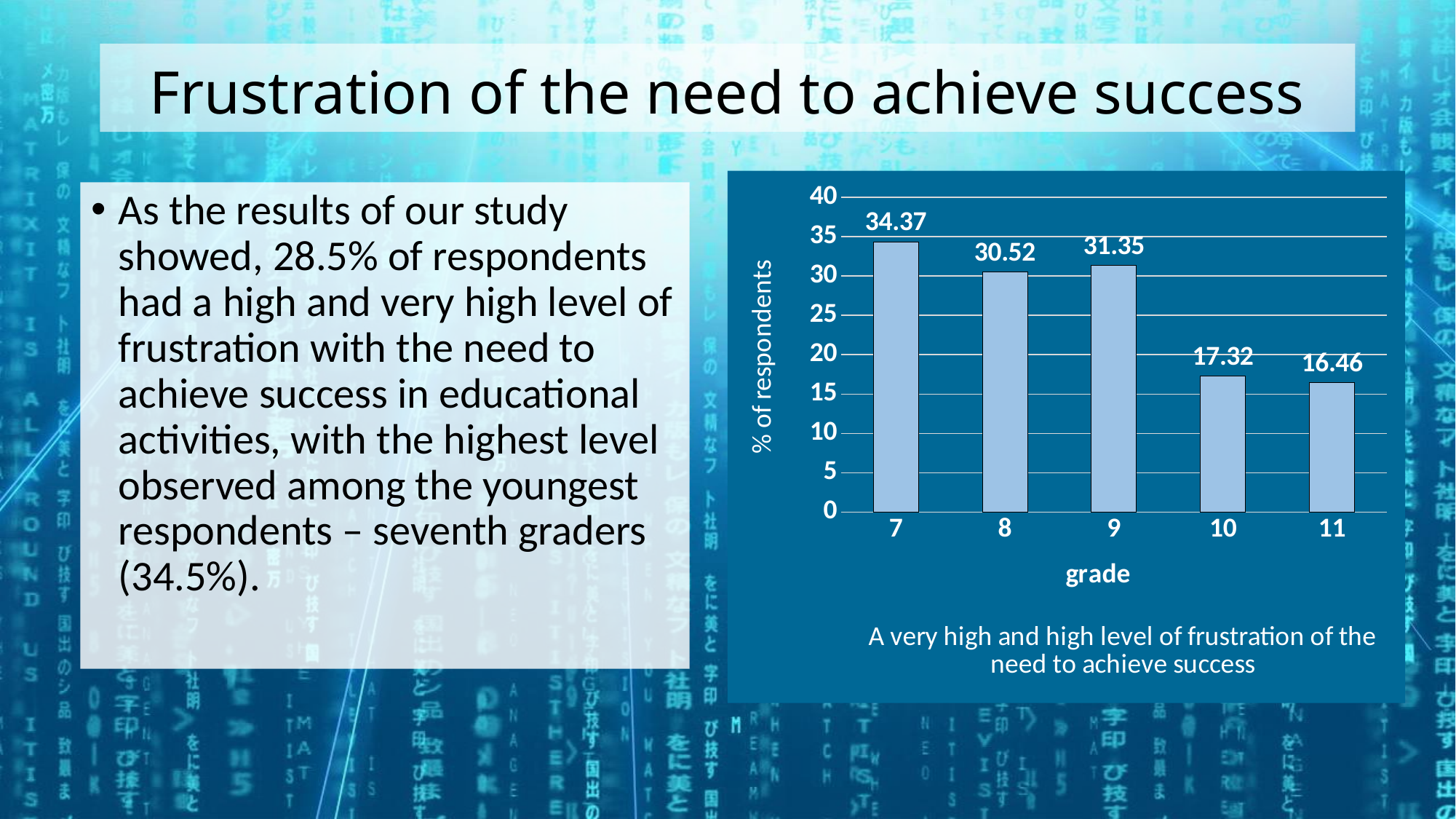
Which is larger, the value for grade 8 or the value for grade 10? grade 8 What is the value for grade 11? 16.46 What kind of chart is shown on the slide? bar chart What is the difference between the values for grade 7 and grade 11? 17.91 What is the value for grade 10? 17.32 Which grade has the highest percentage of respondents? 7 Which grade has the lowest percentage of respondents? 11 What is the difference between the values for grade 9 and grade 8? 0.83 Is the value for grade 9 greater or less than 30? greater What is the label of the y axis? % of respondents What is the value for grade 7? 34.37 How many grades are shown on the x axis? 5